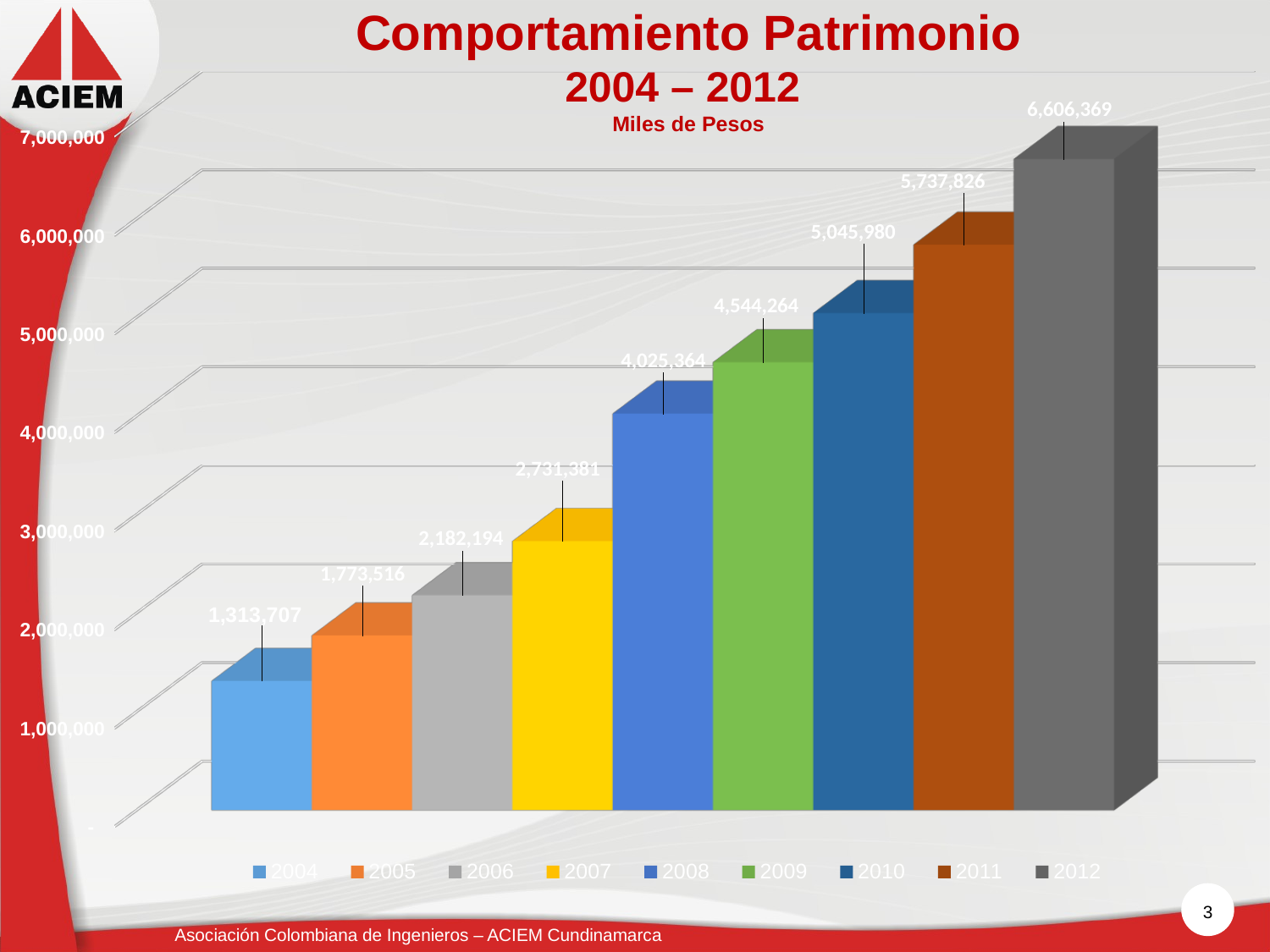
Which is larger, the value for 2009 or the value for 2010? 2010 Which year has the highest value? 2012 Which year has the lowest value? 2004 What is the difference between the values for 2012 and 2004? 5,292,662 What is the value for 2004? 1,313,707 How many years are plotted in the chart? 9 Is the value for 2007 greater or less than 3,000,000? less Do the values rise or fall from 2004 to 2012? rise What is the difference between the values for 2008 and 2007? 1,293,983 What is the value for 2008? 4,025,364 What kind of chart is shown on the slide? bar chart What is the value for 2011? 5,737,826